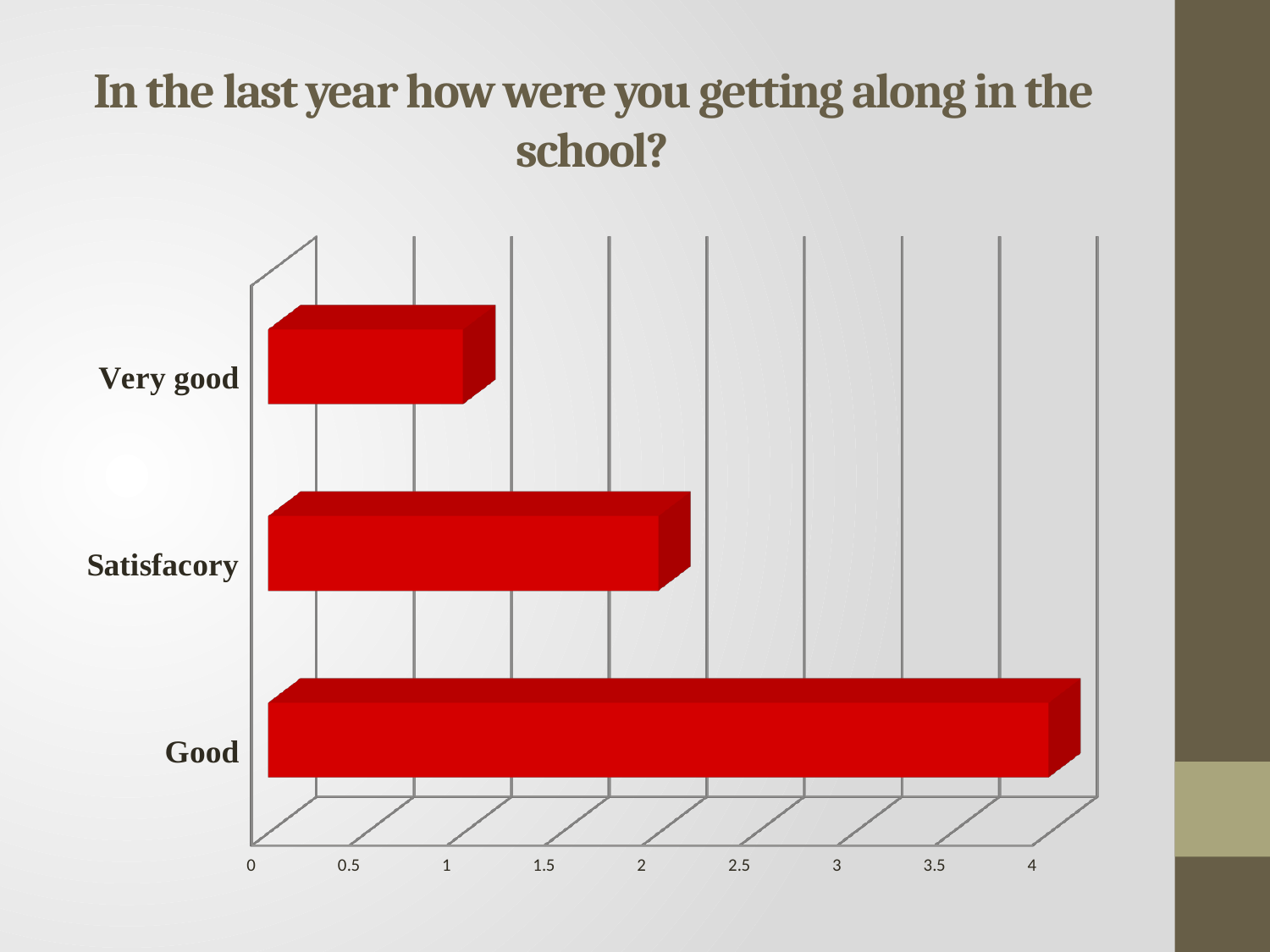
Is the value for Satisfacory greater or less than 3? less Is the value for Good greater or less than 3? greater What kind of chart is shown on the slide? bar chart What is the title of the chart? In the last year how were you getting along in the school? Which category has the lowest value? Very good How many categories are plotted in the chart? 3 What is the highest tick value shown on the horizontal axis? 4 Is the value for Very good greater or less than 2? less Which has the larger value, Satisfacory or Very good? Satisfacory Which category has the highest value? Good Which has the larger value, Good or Satisfacory? Good